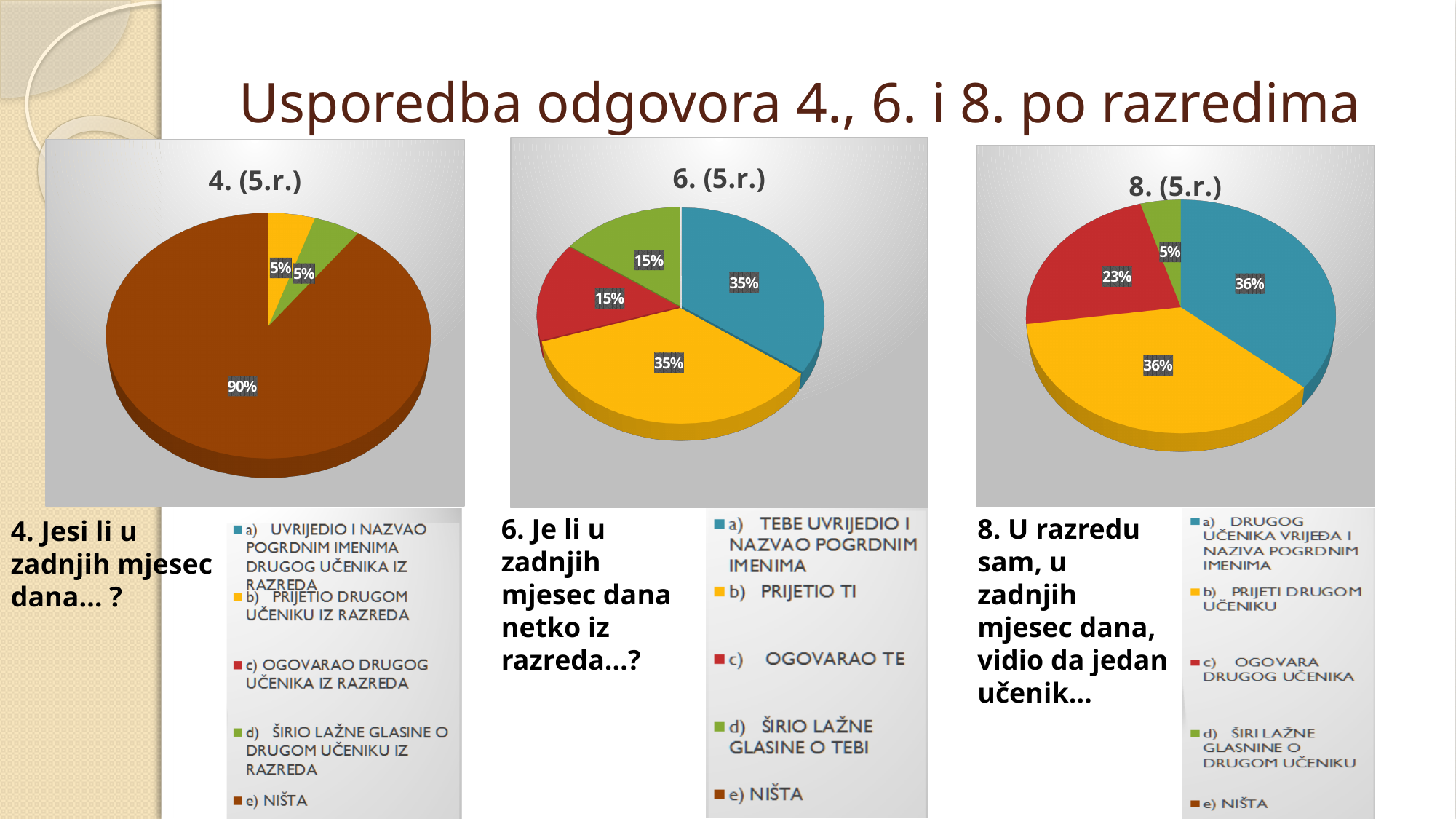
How many slices with data labels are visible in the chart titled "4. (5.r.)"? 3 In the chart titled "4. (5.r.)", which legend entry has the largest slice? e) NIŠTA In the chart titled "8. (5.r.)", what percentage is shown for "c) OGOVARA DRUGOG UČENIKA"? 23% How many entries does the legend of the chart titled "6. (5.r.)" list? 5 What is the title of the slide containing the three pie charts? Usporedba odgovora 4., 6. i 8. po razredima In the chart titled "8. (5.r.)", which is larger: the slice for "c) OGOVARA DRUGOG UČENIKA" or the slice for "d) ŠIRI LAŽNE GLASNINE O DRUGOM UČENIKU"? c) OGOVARA DRUGOG UČENIKA What type of chart is the chart titled "6. (5.r.)"? Pie chart In the chart titled "8. (5.r.)", what is the difference between the "b) PRIJETI DRUGOM UČENIKU" slice and the "c) OGOVARA DRUGOG UČENIKA" slice? 13% In the chart titled "8. (5.r.)", which legend entry has the smallest slice? d) ŠIRI LAŽNE GLASNINE O DRUGOM UČENIKU In the chart titled "6. (5.r.)", what is the difference between the "a) TEBE UVRIJEDIO I NAZVAO POGRDNIM IMENIMA" slice and the "d) ŠIRIO LAŽNE GLASINE O TEBI" slice? 20% In the chart titled "6. (5.r.)", what percentage is shown for "c) OGOVARAO TE"? 15% In the chart titled "4. (5.r.)", what percentage is shown for the slice "e) NIŠTA"? 90%